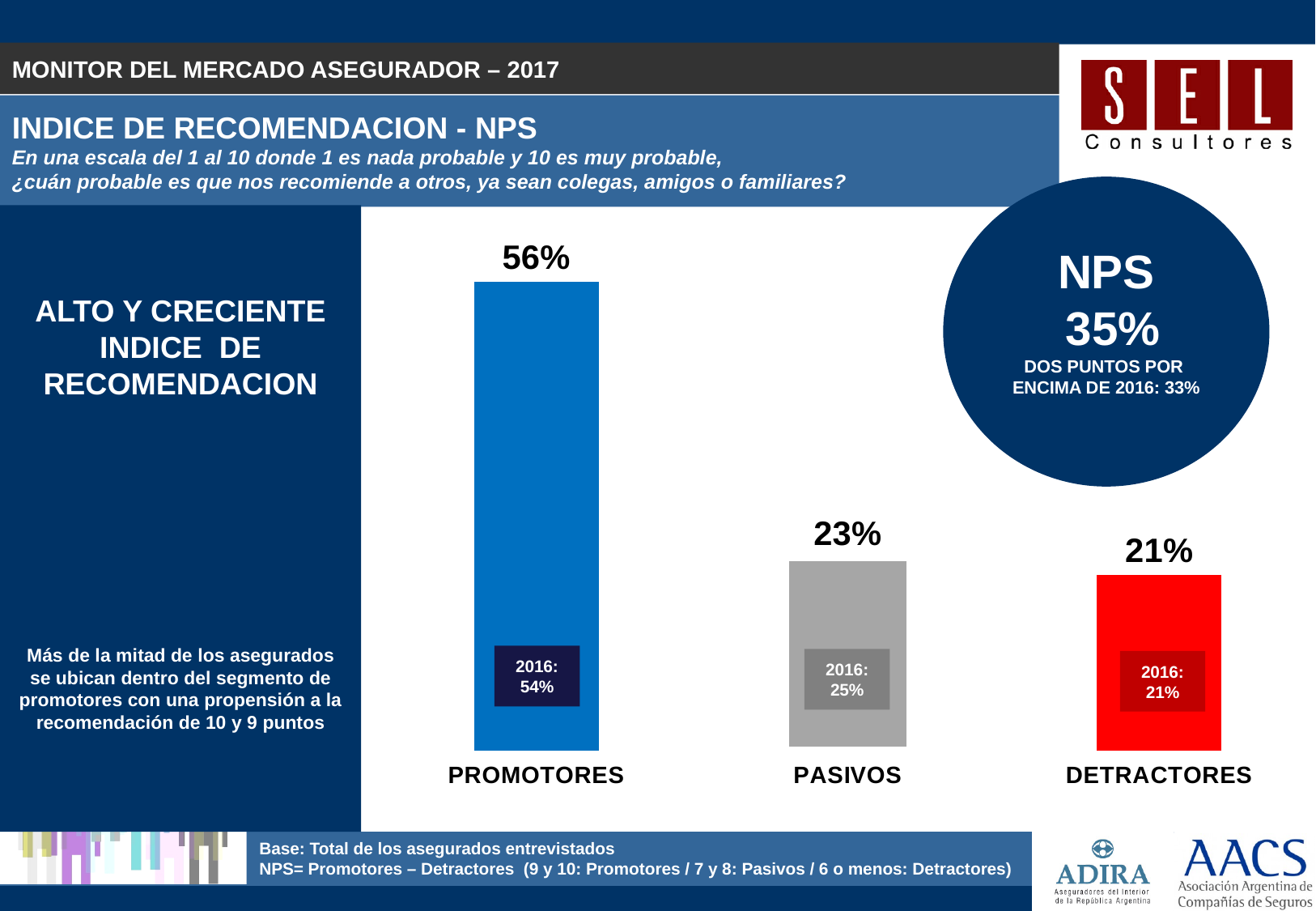
What is the value for DETRACTORES? 21% What colour is the DETRACTORES bar? Red What is the difference between the PROMOTORES and DETRACTORES values? 35% What is the value for PROMOTORES? 56% What was the 2016 value shown inside the PASIVOS bar? 25% How many categories are shown in the chart? 3 What kind of chart is shown on the slide? Bar chart What was the 2016 value shown inside the PROMOTORES bar? 54% What is the value for PASIVOS? 23% Which category has the highest value? PROMOTORES Which category has the lowest value? DETRACTORES Which is larger, the value for PASIVOS or the value for DETRACTORES? PASIVOS